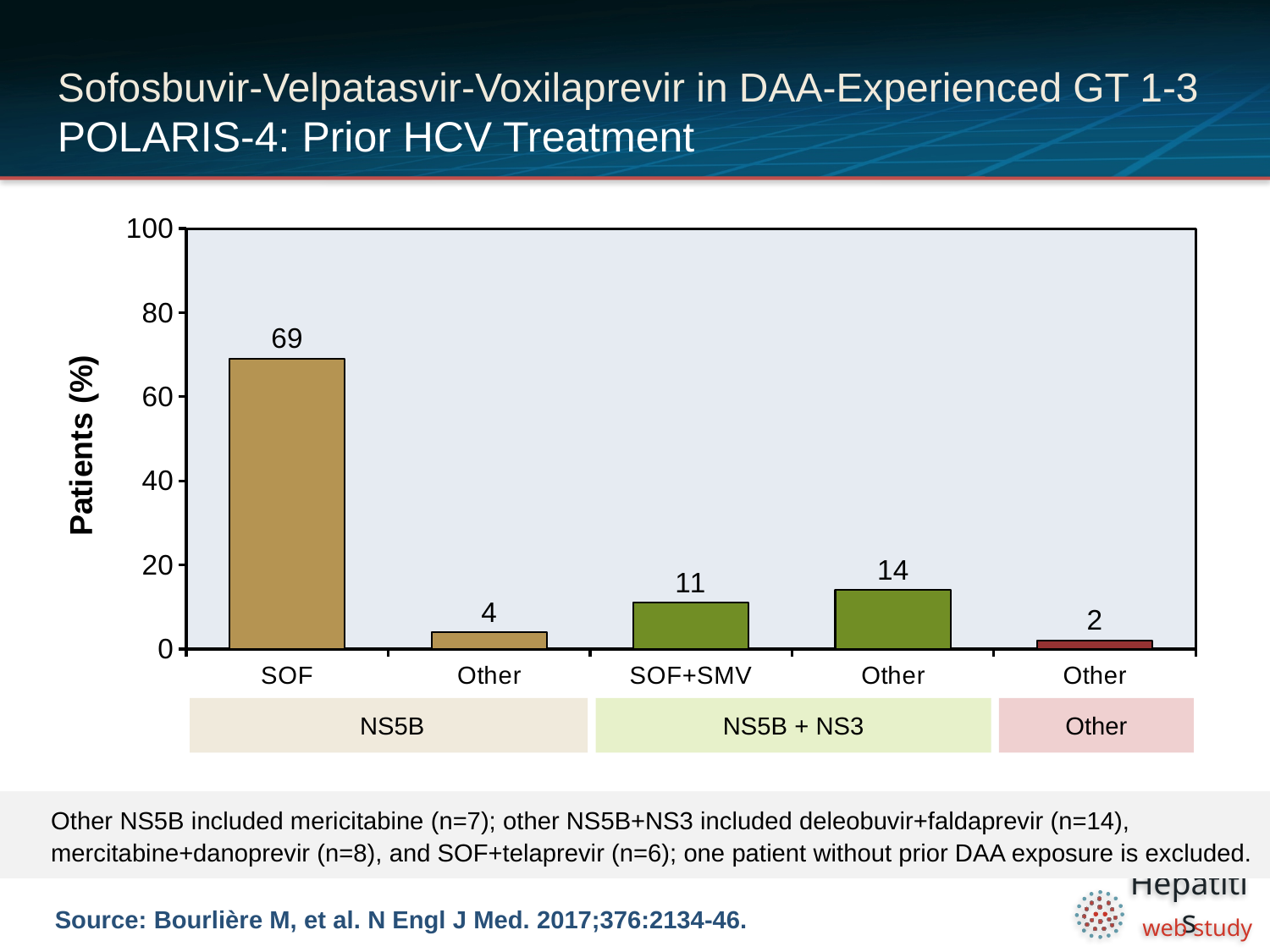
What is the value for SOF+SMV in the NS5B + NS3 group? 11 What is the label of the y-axis? Patients (%) What is the value for the Other bar within the NS5B group? 4 How many bars are plotted in the chart? 5 What is the difference between the SOF bar and the SOF+SMV bar? 58 Which prior treatment category has the highest percentage of patients? SOF What is the value for the bar in the Other (non-NS5B, non-NS3) group? 2 What type of chart is shown on the slide? Bar chart Which bar has the lowest value? Other (in the Other group) What is the value for the Other bar within the NS5B + NS3 group? 14 What percentage of patients had prior SOF treatment in the NS5B group? 69 Which is larger: the Other bar in the NS5B + NS3 group or the SOF+SMV bar? Other in the NS5B + NS3 group